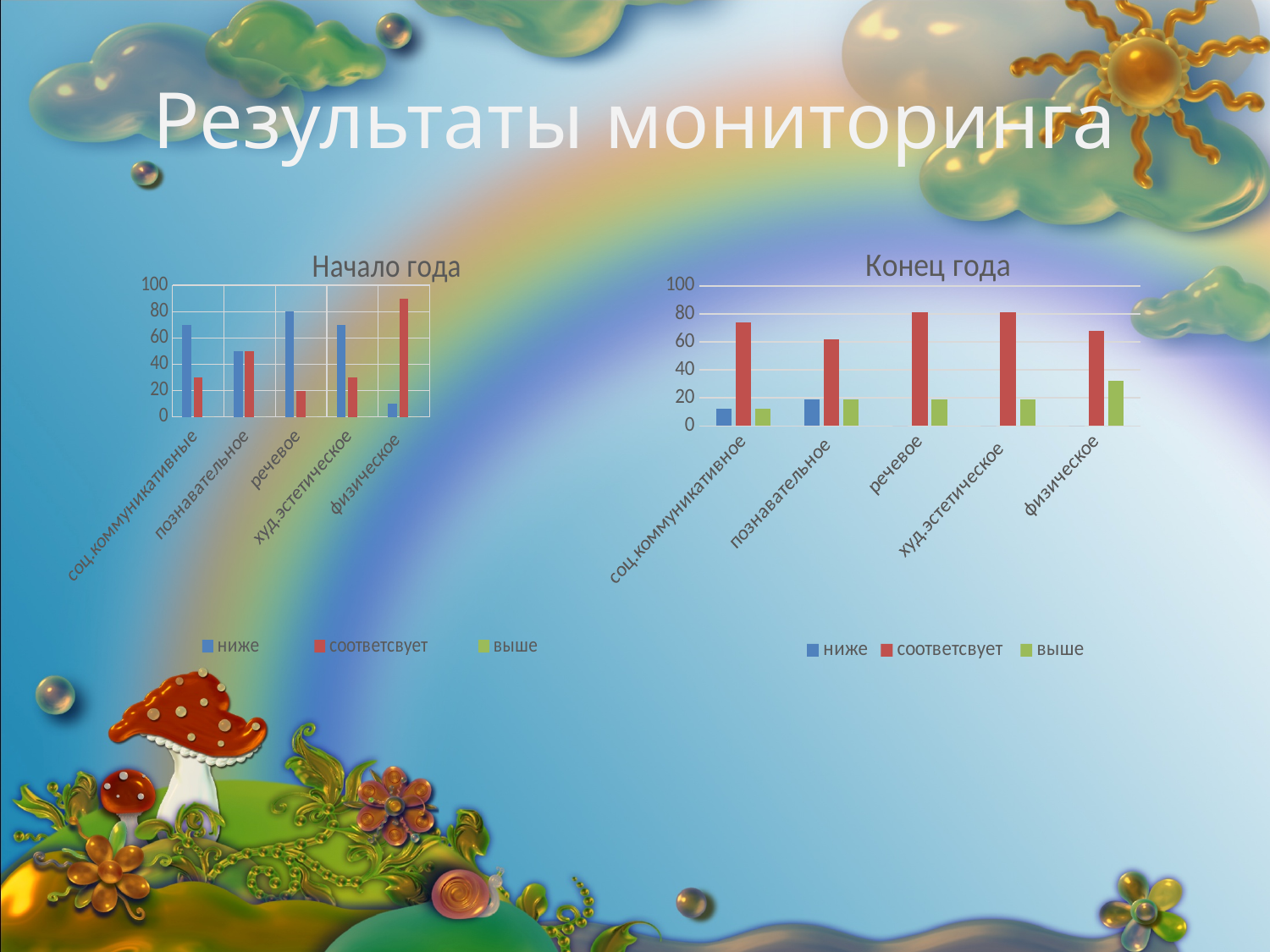
In the "Конец года" chart, which is larger for "познавательное": "ниже" or "соответсвует"? соответсвует What is the title of the chart on the right side of the slide? Конец года What type of chart is the "Начало года" chart? bar chart In the "Начало года" chart, is the value of "ниже" for "речевое" greater or less than 60? greater How many categories are shown on the x axis of the "Начало года" chart? 5 In the "Конец года" chart, which category has the highest value for the "выше" series? физическое How many series does the legend of the "Конец года" chart list? 3 In the "Начало года" chart, which category has the highest value for the "соответсвует" series? физическое In the "Конец года" chart, is the value of "соответсвует" for "речевое" greater or less than 60? greater In the "Начало года" chart, which is larger for "соц.коммуникативные": "ниже" or "соответсвует"? ниже In the "Начало года" chart, is the value of "соответсвует" for "речевое" greater or less than 40? less In the "Начало года" chart, which category has the lowest value for the "ниже" series? физическое